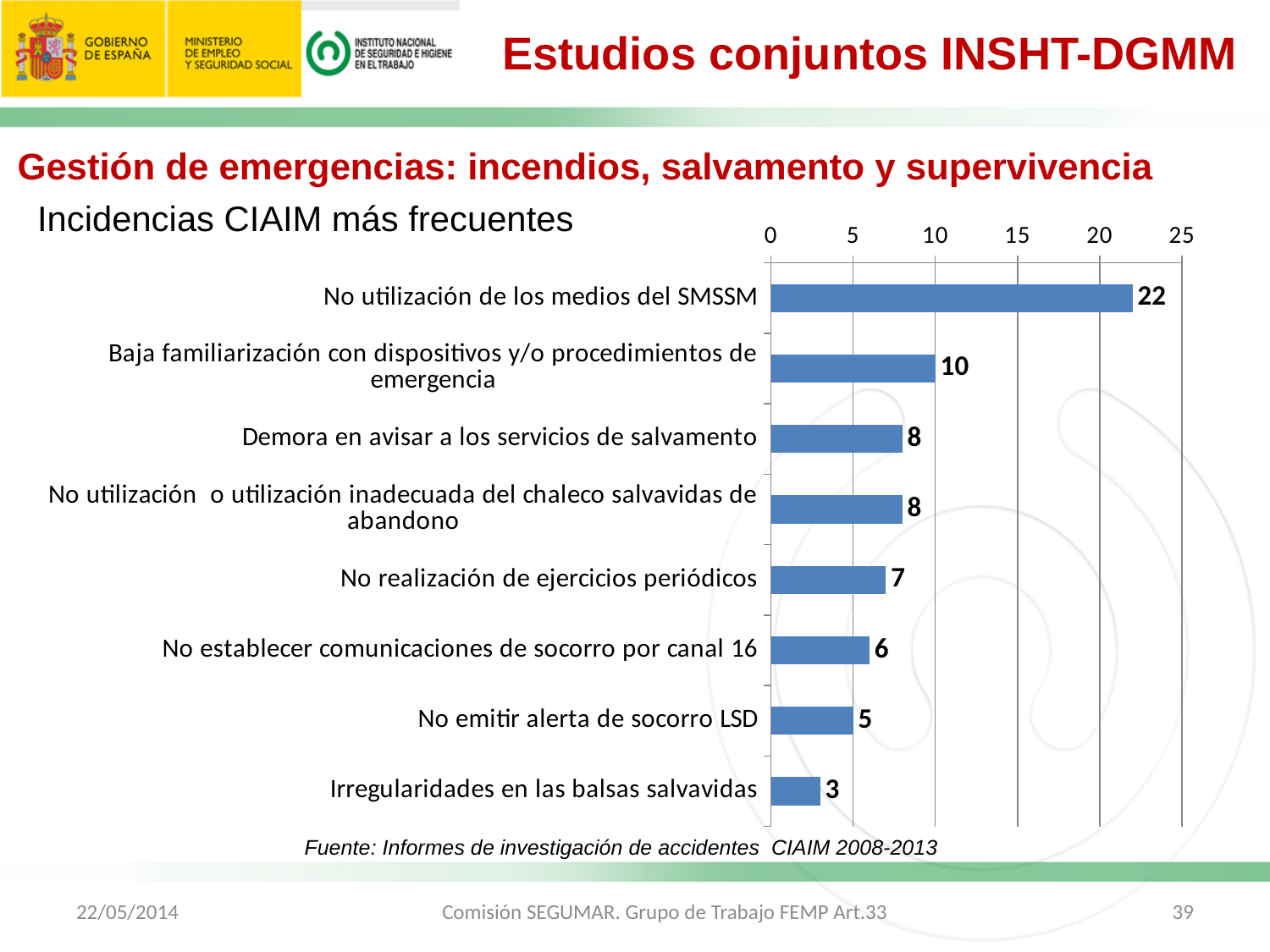
What is the value for "Demora en avisar a los servicios de salvamento"? 8 Is the value for "Baja familiarización con dispositivos y/o procedimientos de emergencia" greater or less than 15? less What is the value for "Irregularidades en las balsas salvavidas"? 3 How many categories are shown in the chart? 8 Which is larger: the value for "No realización de ejercicios periódicos" or the value for "No establecer comunicaciones de socorro por canal 16"? No realización de ejercicios periódicos What kind of chart is shown on the slide? Bar chart What is the maximum value shown on the chart's axis? 25 What is the difference between the values for "No utilización de los medios del SMSSM" and "Baja familiarización con dispositivos y/o procedimientos de emergencia"? 12 Which category has the highest value? No utilización de los medios del SMSSM What is the value for "No utilización de los medios del SMSSM"? 22 What is the value for "No emitir alerta de socorro LSD"? 5 Which category has the lowest value? Irregularidades en las balsas salvavidas